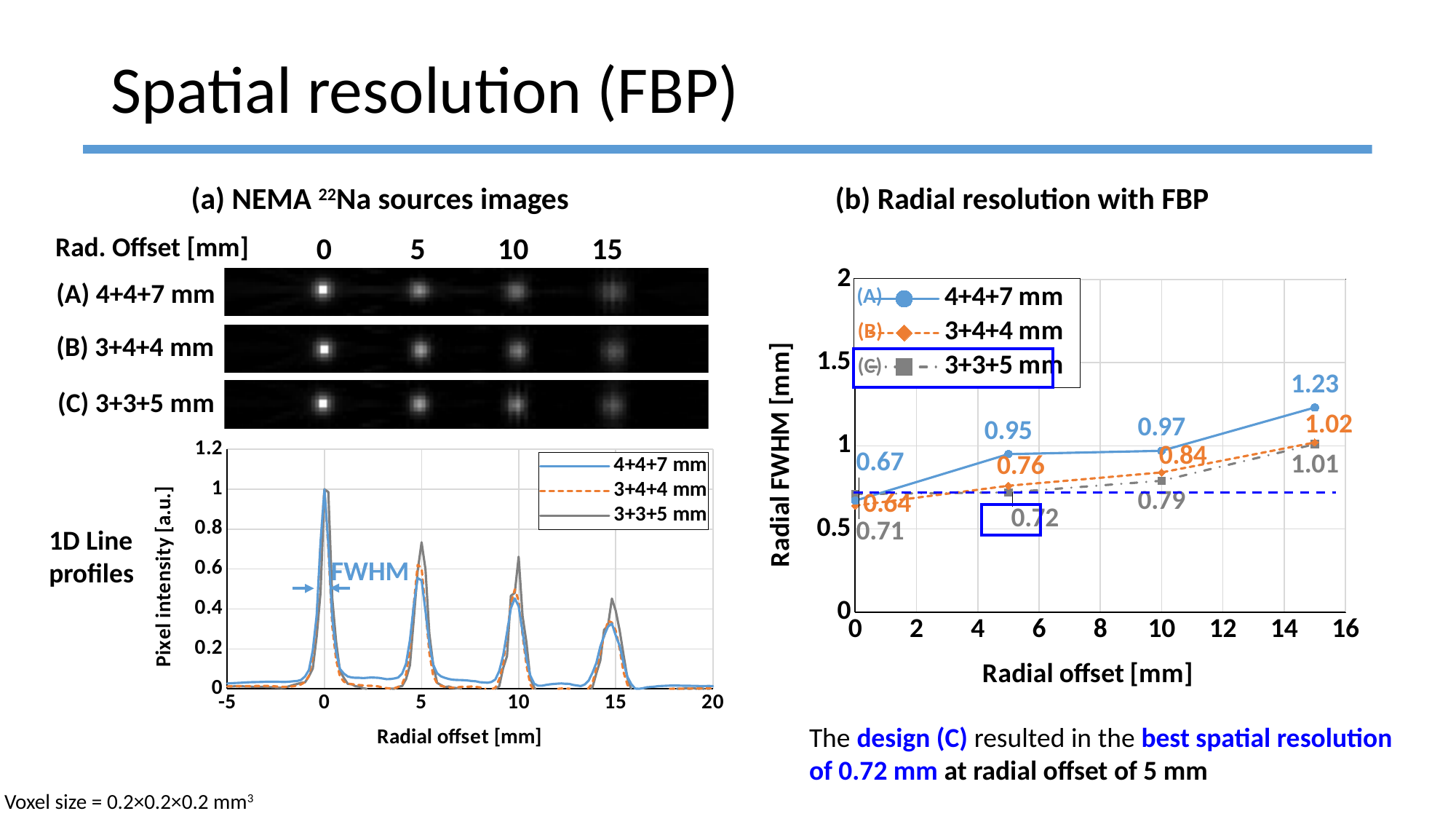
In the 'Radial resolution with FBP' chart, which is larger at a radial offset of 10 mm: the 4+4+7 mm value or the 3+3+5 mm value? 4+4+7 mm In the 'Radial resolution with FBP' chart, what is the radial FWHM for the 4+4+7 mm series at a radial offset of 15 mm? 1.23 In the 'Radial resolution with FBP' chart, what is the radial FWHM for the 3+3+5 mm series at a radial offset of 5 mm? 0.72 In the 'Radial resolution with FBP' chart, is the 4+4+7 mm value at a radial offset of 15 mm greater or less than 1? greater What is the y-axis label of the 'Radial resolution with FBP' chart? Radial FWHM [mm] In the 'Radial resolution with FBP' chart, which series has the lowest radial FWHM at a radial offset of 0 mm? 3+4+4 mm In the 'Radial resolution with FBP' chart, which series has the highest radial FWHM at a radial offset of 15 mm? 4+4+7 mm What kind of chart is the '1D Line profiles' chart on the left of the slide? line chart In the 'Radial resolution with FBP' chart, what is the radial FWHM for the 3+4+4 mm series at a radial offset of 10 mm? 0.84 In the 'Radial resolution with FBP' chart, what is the difference between the 4+4+7 mm and 3+3+5 mm values at a radial offset of 5 mm? 0.23 How many series does the legend of the 'Radial resolution with FBP' chart list? 3 In the 'Radial resolution with FBP' chart, does the radial FWHM for the 3+4+4 mm series rise or fall as the radial offset increases? rise